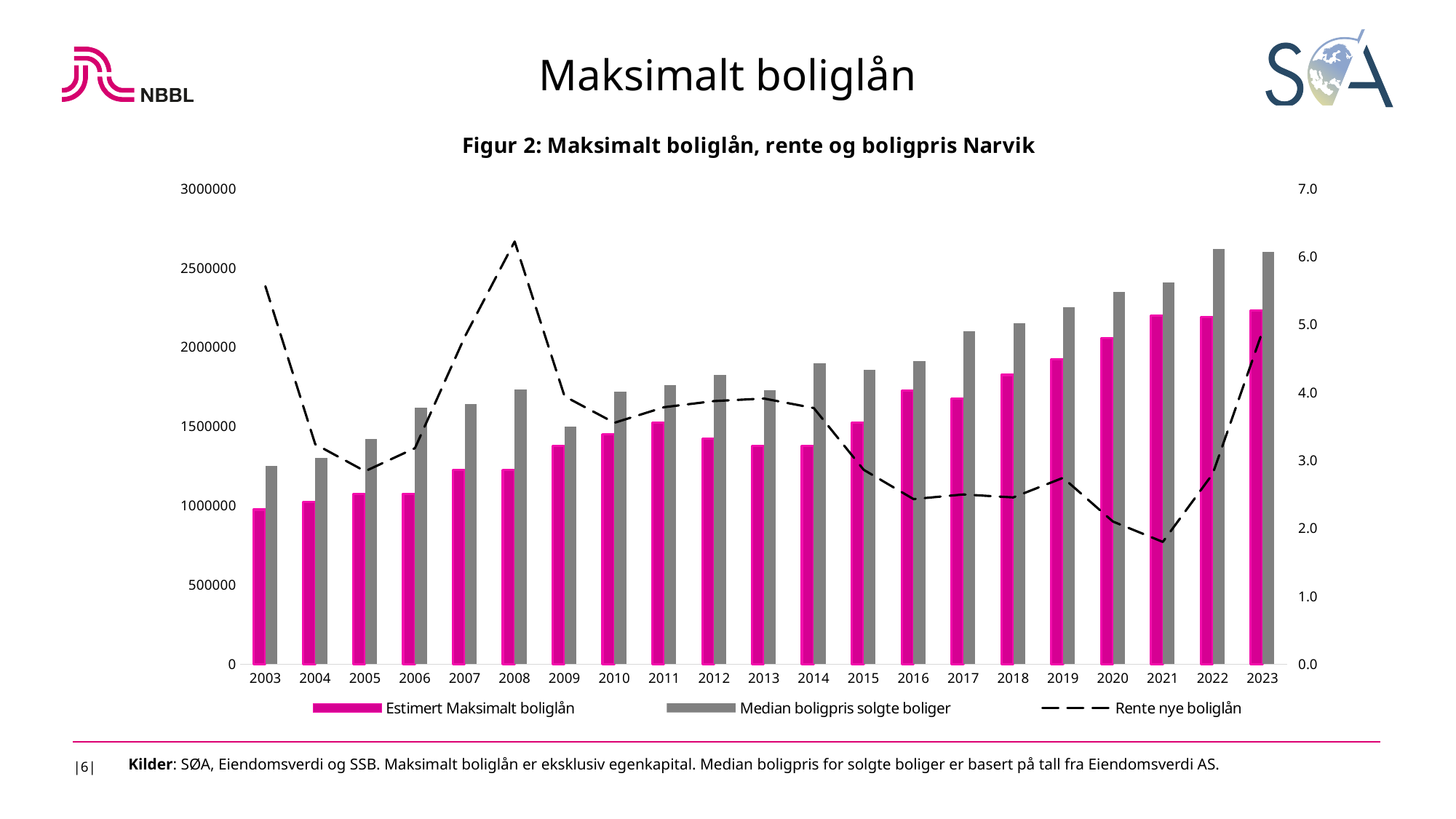
What kind of chart is shown in Figur 2? A bar chart combined with a dashed line How many series does the legend list? 3 In which year is the Rente nye boliglån line at its highest? 2008 In which year is the Rente nye boliglån line at its lowest? 2021 In which year is Estimert Maksimalt boliglån lowest? 2003 Is the value for Median boligpris solgte boliger in 2022 greater or less than 2500000? greater How many years are shown on the x axis? 21 Which is larger in 2023: Estimert Maksimalt boliglån or Median boligpris solgte boliger? Median boligpris solgte boliger Does Estimert Maksimalt boliglån generally rise or fall from 2003 to 2023? Rise Is the Rente nye boliglån value in 2008 greater or less than 6.0? greater In which year is Median boligpris solgte boliger lowest? 2003